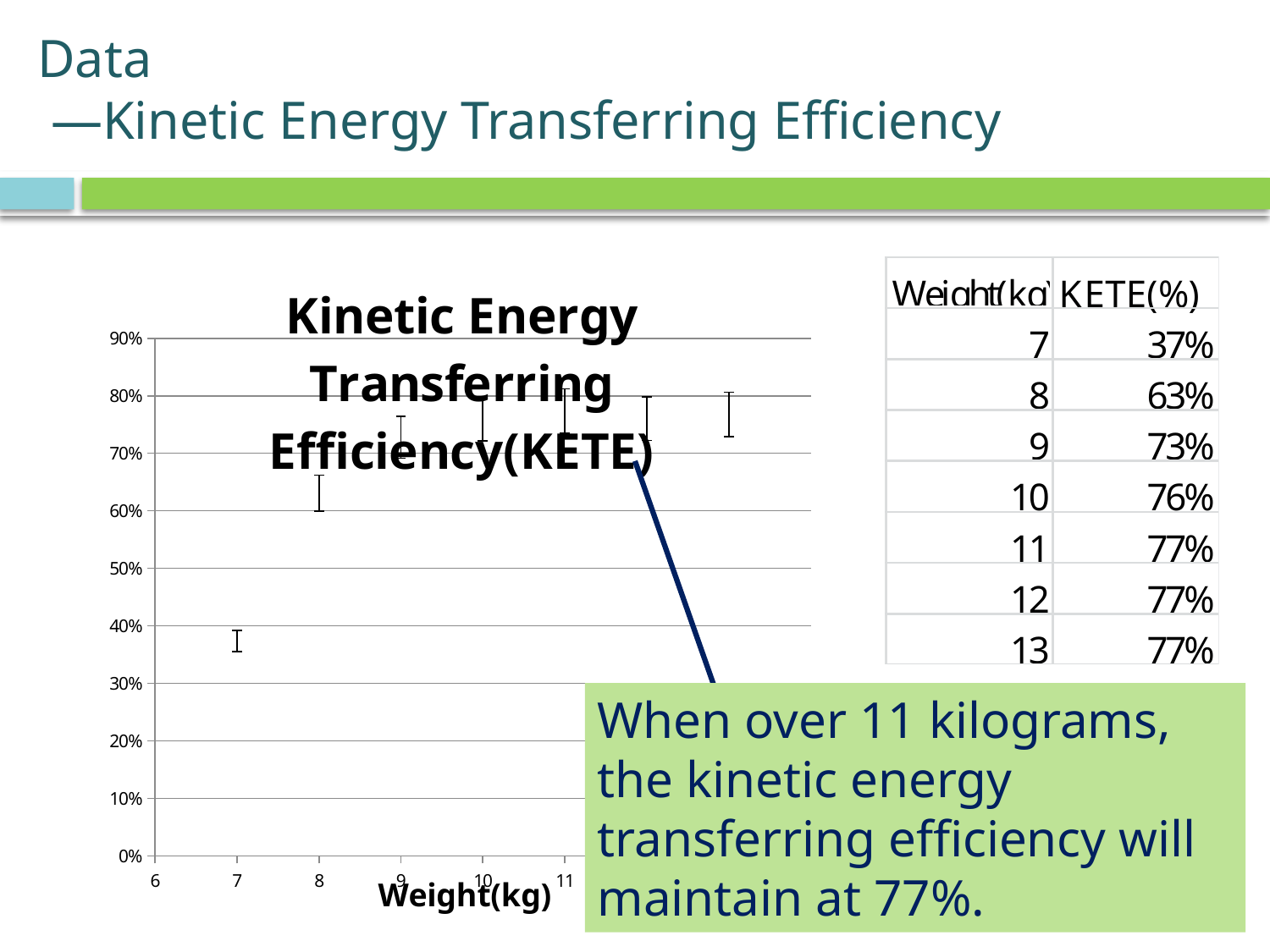
Is the KETE value at 10 kg greater or less than 70%? greater According to the table on the slide, what is the KETE for a weight of 7 kg? 37% Does the KETE rise or fall as weight increases along the x axis? rise What kind of chart is shown on the slide? scatter chart Which weight has the lowest KETE in the chart? 7 kg Is the KETE value at 8 kg greater or less than 60%? greater According to the table on the slide, what is the KETE for a weight of 9 kg? 73% What is the title of the chart? Kinetic Energy Transferring Efficiency(KETE) Is the KETE value at 7 kg greater or less than 50%? less According to the table on the slide, what is the KETE for a weight of 12 kg? 77% Which has a higher KETE, 7 kg or 9 kg? 9 kg What is the x-axis title of the chart? Weight(kg)